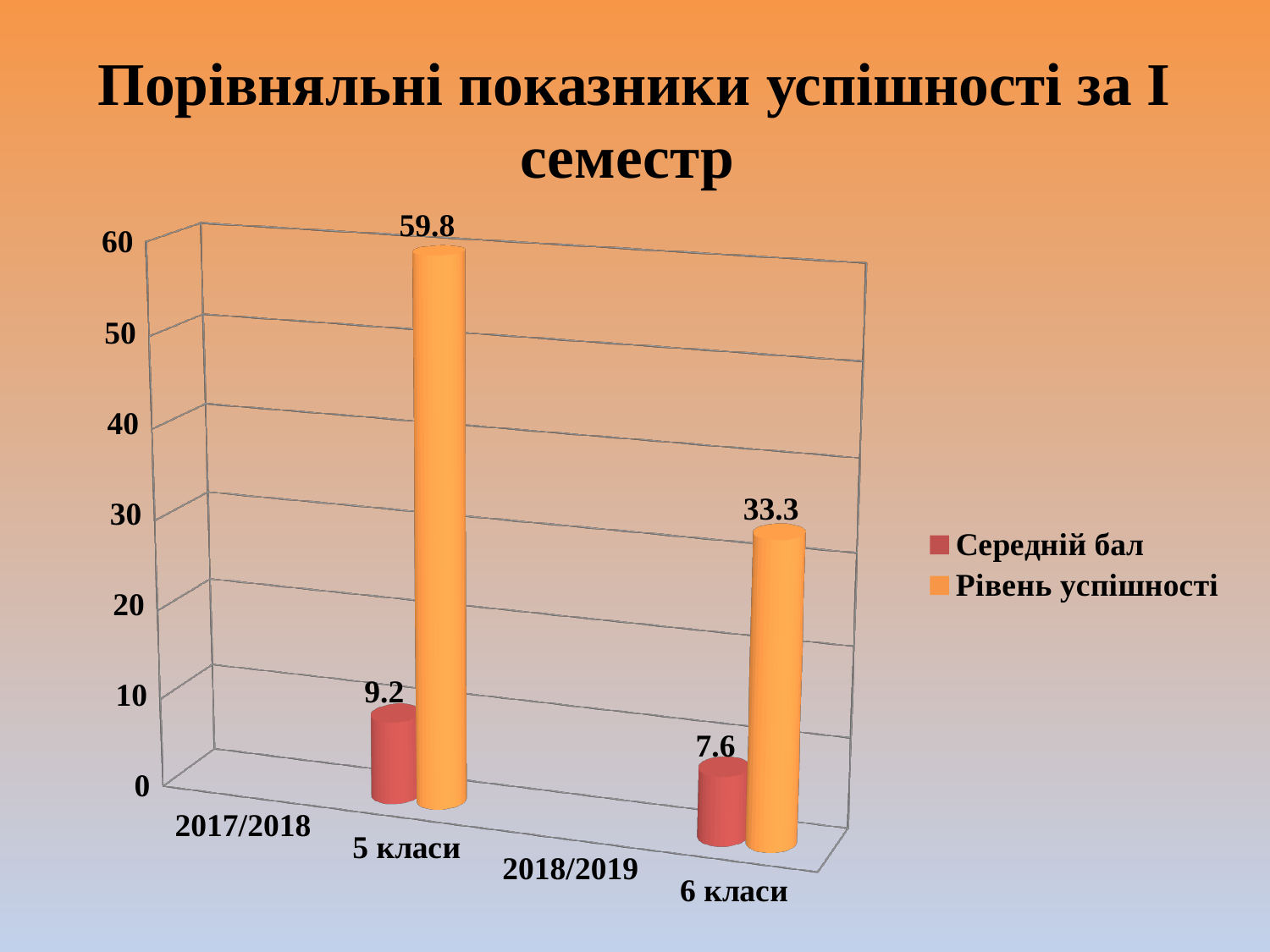
How many series does the legend list? 2 What kind of chart is shown on the slide? Bar chart Which is larger: Середній бал for 2017/2018 5 класи or for 2018/2019 6 класи? 2017/2018 5 класи Which category has the lowest Середній бал? 2018/2019 6 класи What is the difference in Рівень успішності between 2017/2018 5 класи and 2018/2019 6 класи? 26.5 What is the value of Середній бал for 2018/2019 6 класи? 7.6 What is the difference in Середній бал between 2017/2018 5 класи and 2018/2019 6 класи? 1.6 How many categories are shown on the x axis? 4 What is the value of Рівень успішності for 2018/2019 6 класи? 33.3 What is the value of Рівень успішності for 2017/2018 5 класи? 59.8 Which category has the highest Рівень успішності? 2017/2018 5 класи What is the value of Середній бал for 2017/2018 5 класи? 9.2